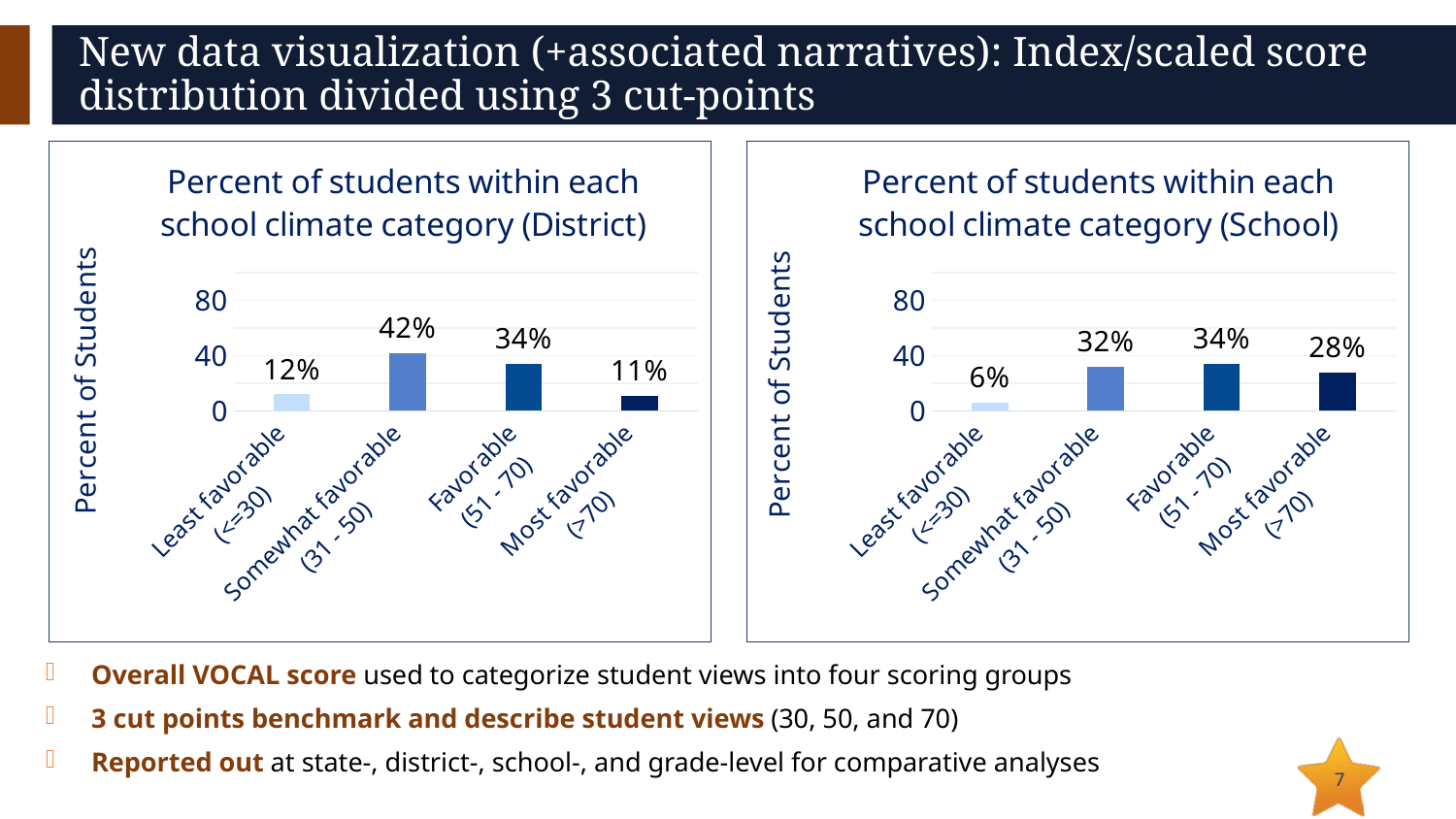
In the School chart, is the value for Somewhat favorable (31 - 50) greater or less than 40? less In the School chart, which category has the lowest percent of students? Least favorable (<=30) In the School chart, what percent of students are in the Least favorable (<=30) category? 6% In the District chart, which is larger: the Favorable (51 - 70) value or the Least favorable (<=30) value? Favorable (51 - 70) How many categories are shown in the District chart? 4 What kind of chart is the School chart? bar chart In the District chart, what percent of students are in the Somewhat favorable (31 - 50) category? 42% In the School chart, what is the difference between the Favorable (51 - 70) and Most favorable (>70) percentages? 6% In the District chart, what is the value for Most favorable (>70)? 11% In the District chart, what is the difference between the Somewhat favorable (31 - 50) and Most favorable (>70) percentages? 31% In the District chart, which category has the highest percent of students? Somewhat favorable (31 - 50) What is the y-axis label of the School chart? Percent of Students